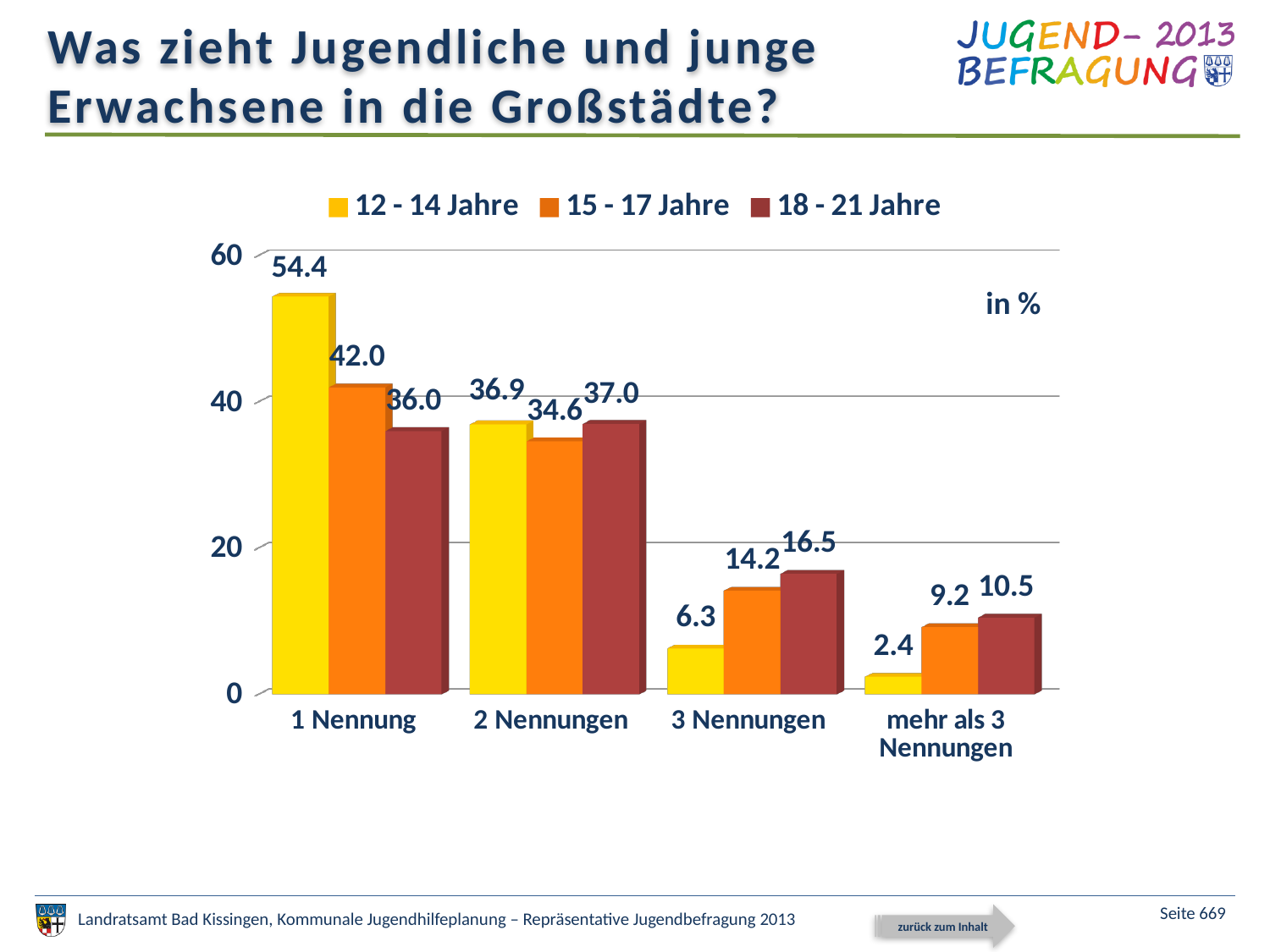
Which category has the lowest value for the 18 - 21 Jahre series? mehr als 3 Nennungen Which category has the highest value for the 15 - 17 Jahre series? 1 Nennung At 3 Nennungen, which series has the larger value: 12 - 14 Jahre or 18 - 21 Jahre? 18 - 21 Jahre Do the values for the 12 - 14 Jahre series rise or fall from 1 Nennung to mehr als 3 Nennungen? fall What is the difference between the 12 - 14 Jahre and 18 - 21 Jahre values at 1 Nennung? 18.4 What is the value for the 12 - 14 Jahre series at mehr als 3 Nennungen? 2.4 What is the value for the 12 - 14 Jahre series at 1 Nennung? 54.4 How many categories are shown on the x axis? 4 What kind of chart is shown on the slide? bar chart What is the value for the 18 - 21 Jahre series at 2 Nennungen? 37.0 What is the value for the 15 - 17 Jahre series at 3 Nennungen? 14.2 How many series does the legend list? 3